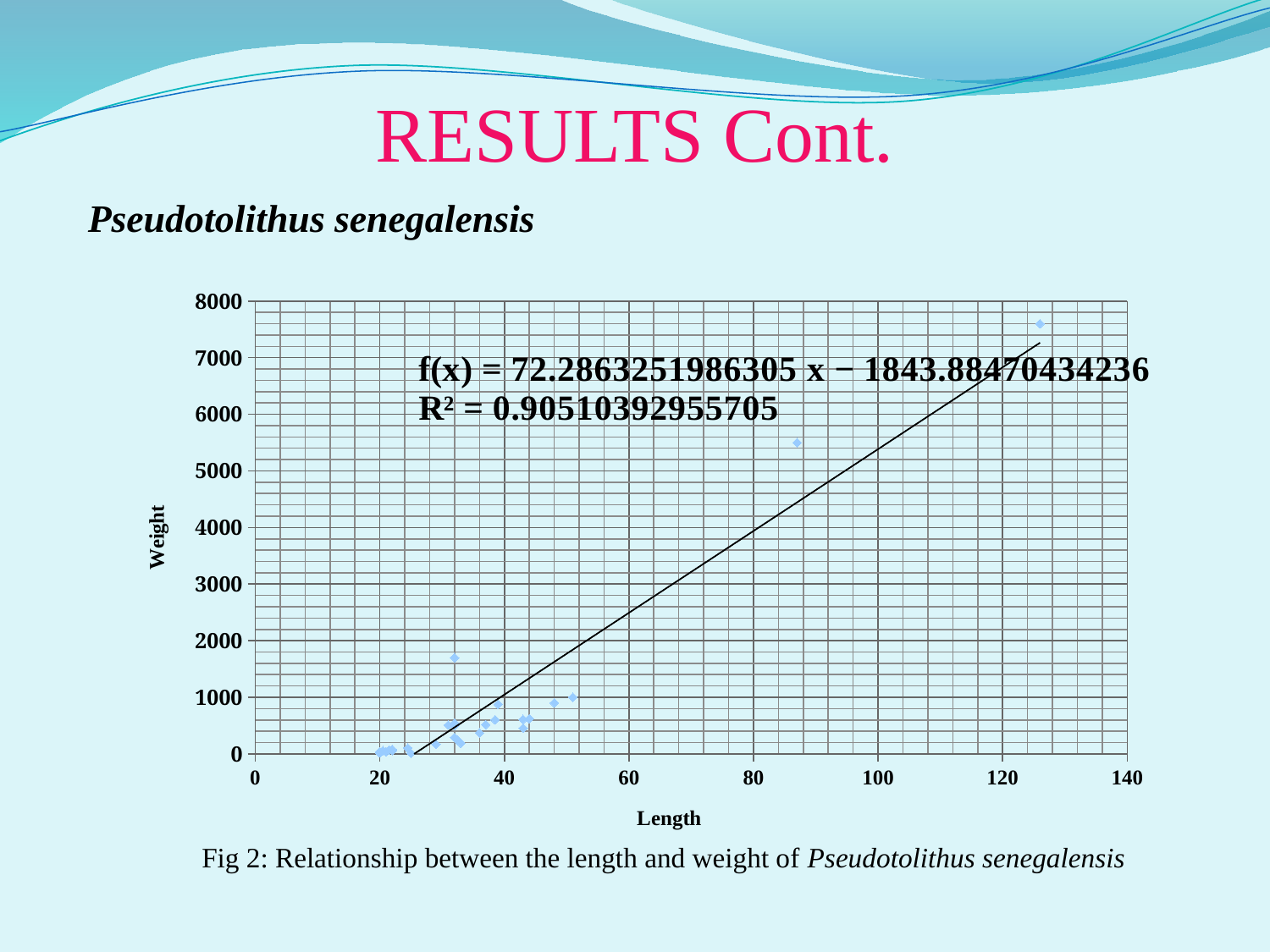
Is the weight of the point at a length of about 87 greater or less than 5000? greater What is the slope of the fitted line f(x) printed on the chart? 72.2863251986305 What is the label of the x axis? Length What is the label of the y axis? Weight What is the maximum value shown on the y axis? 8000 What is the intercept of the fitted line f(x) printed on the chart? − 1843.88470434236 Is the weight of the point with the greatest length greater or less than 7000? greater Is the weight of the point at a length of about 87 greater or less than 6000? less What kind of chart is shown on the slide? Scatter chart What is the maximum value shown on the x axis? 140 Does weight rise or fall as length increases along the x axis? Rise What is the R² value printed on the chart? 0.90510392955705